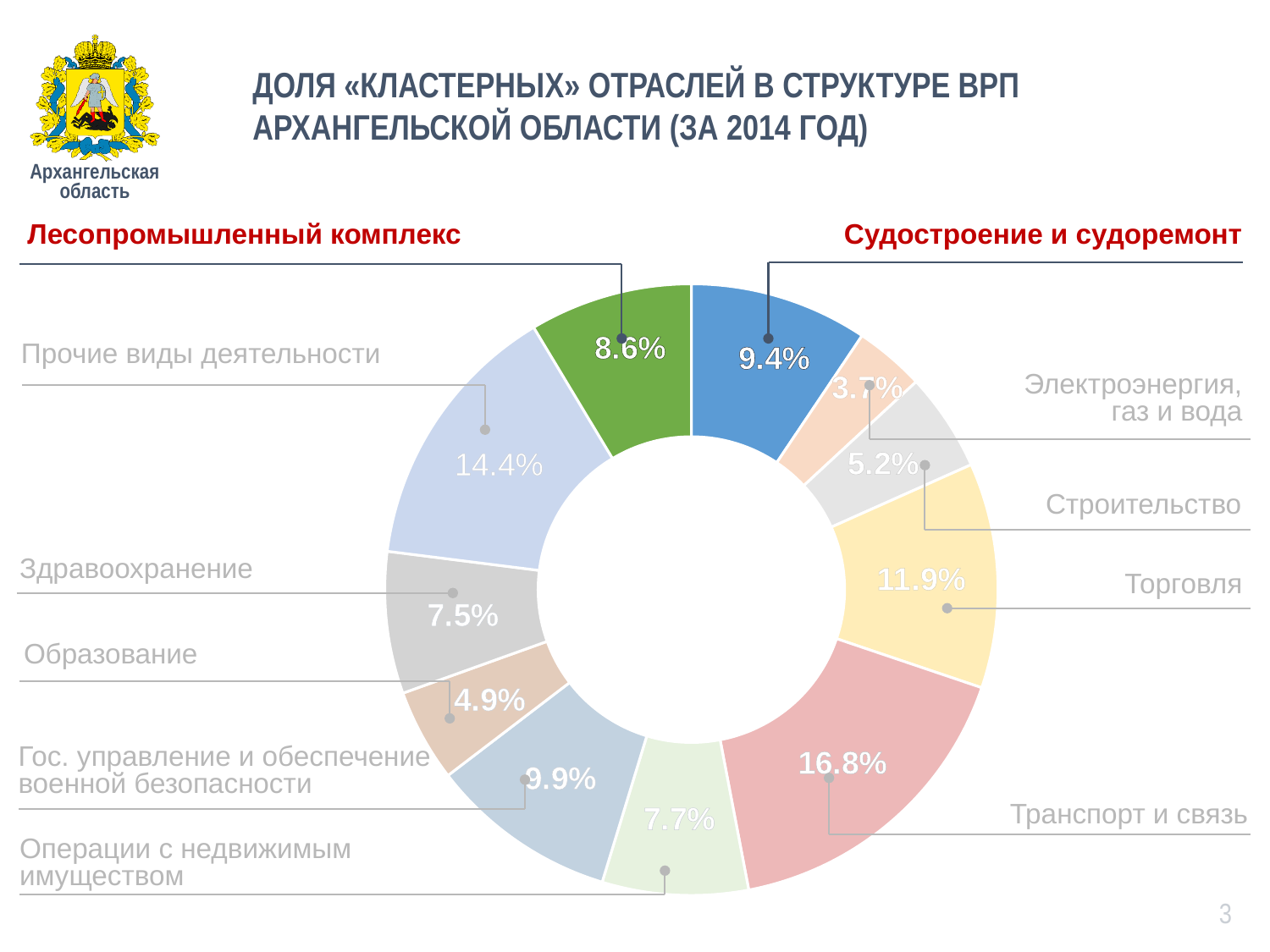
What share does Лесопромышленный комплекс have in the chart? 8.6% Which has a larger share: Торговля or Прочие виды деятельности? Прочие виды деятельности What share does Строительство have in the chart? 5.2% What share does Здравоохранение have in the chart? 7.5% What is the difference between the shares of Судостроение и судоремонт and Лесопромышленный комплекс? 0.8% What share does Торговля have in the chart? 11.9% Which sector has the largest share in the chart? Транспорт и связь How many segments does the doughnut chart have? 11 Which sector has the smallest share in the chart? Электроэнергия, газ и вода What share does Транспорт и связь have in the chart? 16.8% What kind of chart is shown on the slide? Doughnut (pie) chart What share does Судостроение и судоремонт have in the chart? 9.4%